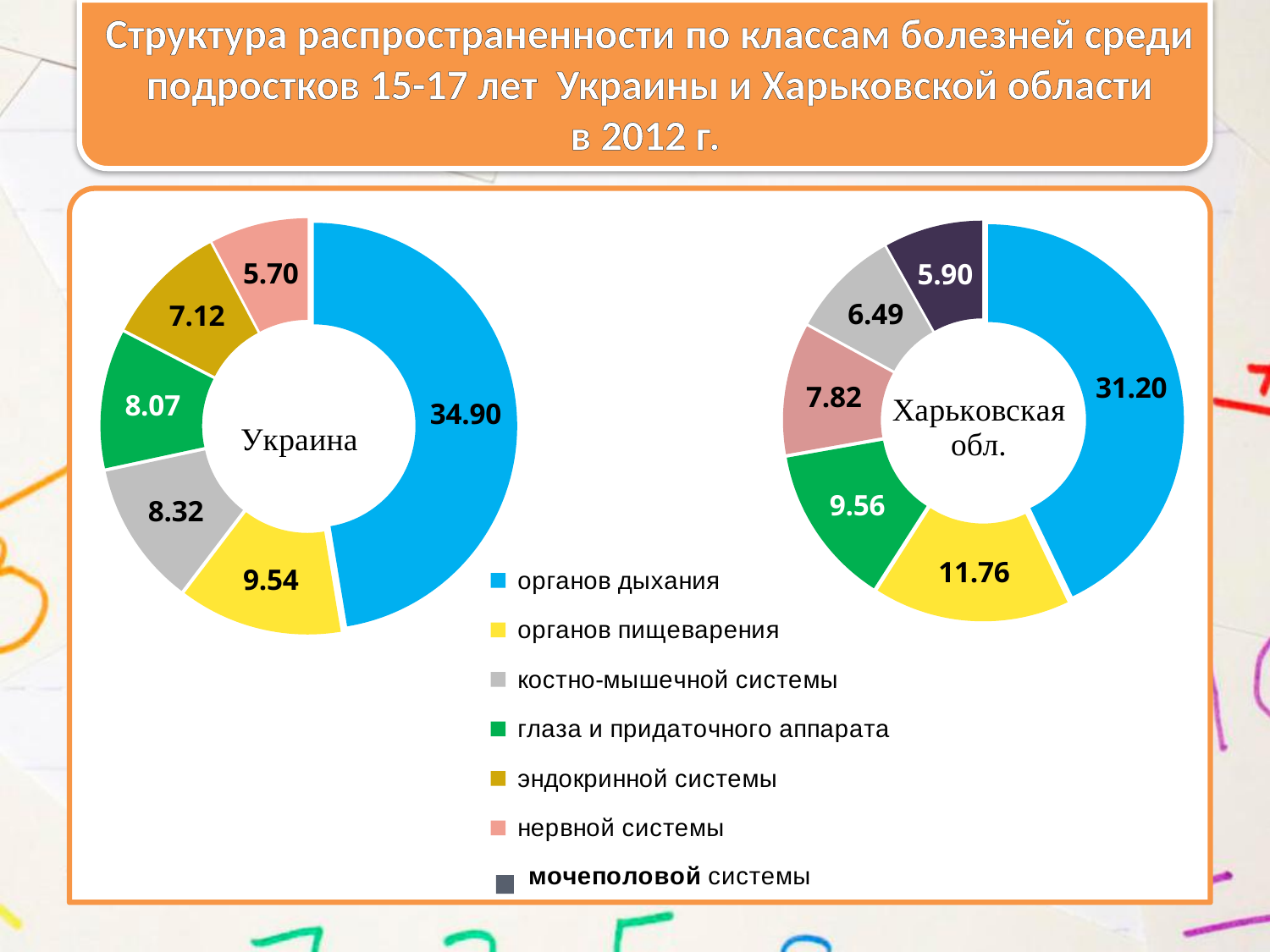
In the Харьковская обл. chart, which category has the smallest value? мочеполовой системы In the Украина chart, what is the value for органов дыхания? 34.90 How many entries does the shared legend list? 7 In the Украина chart, which category has the smallest value? нервной системы How many slices does the Харьковская обл. chart have? 6 Which is larger: глаза и придаточного аппарата in the Украина chart or in the Харьковская обл. chart? Харьковская обл. In the Харьковская обл. chart, what is the value for органов пищеварения? 11.76 What is the difference between the органов дыхания values in the Украина chart and the Харьковская обл. chart? 3.70 What type of chart is used for Украина? Doughnut chart In the Харьковская обл. chart, what is the value for мочеполовой системы? 5.90 In the Украина chart, which category has the largest value? органов дыхания In the Украина chart, what is the value for эндокринной системы? 7.12